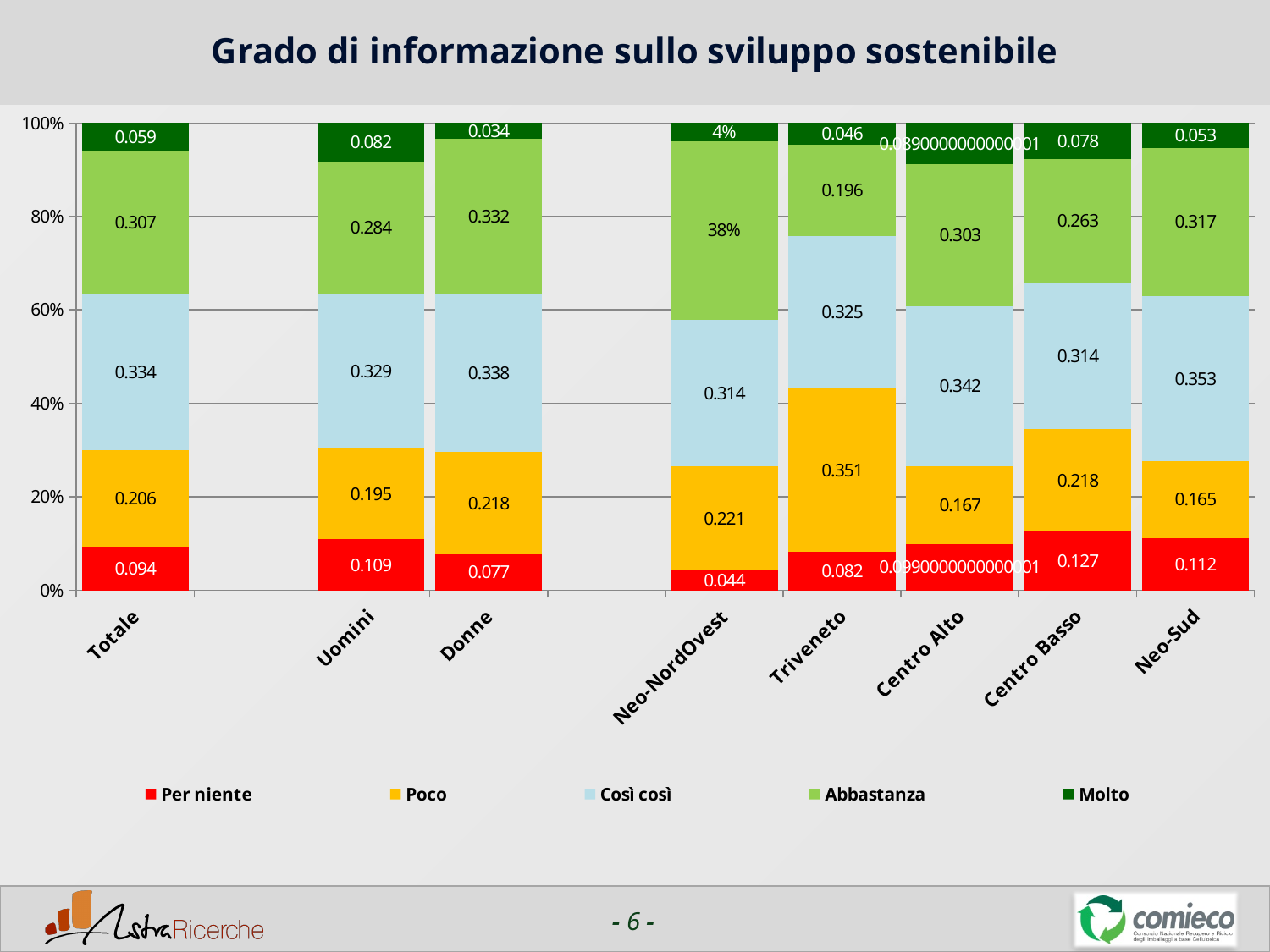
What is the value of 'Abbastanza' for Neo-NordOvest? 38% What kind of chart is shown on the slide? stacked bar chart What is the value of 'Per niente' for Totale? 0.094 What is the difference between the 'Poco' values for Donne and Uomini? 0.023 Which is larger, the 'Abbastanza' value for Donne or for Centro Basso? Donne What is the value of 'Così così' for Neo-Sud? 0.353 How many series does the legend list? 5 Which category has the lowest value for 'Molto'? Donne How many categories are shown on the x axis? 8 What is the value of 'Poco' for Triveneto? 0.351 What is the value of 'Molto' for Uomini? 0.082 Which category has the highest value for 'Per niente'? Centro Basso